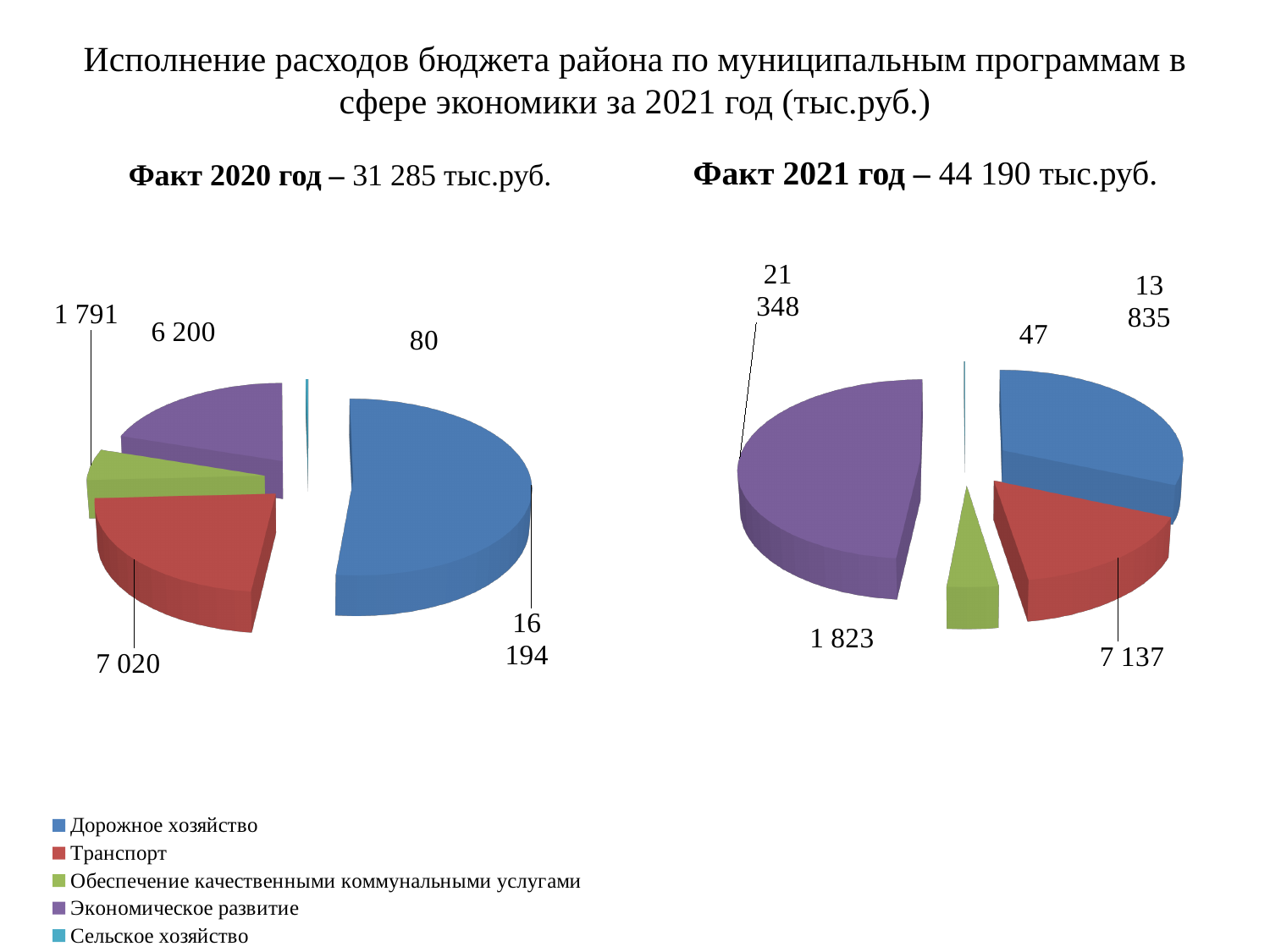
In the 2020 pie chart (Факт 2020 год), which category has the largest value? Дорожное хозяйство In the 2020 pie chart (Факт 2020 год), what is the value for Сельское хозяйство? 80 How many categories does the legend list for the pie charts? 5 In the 2021 pie chart (Факт 2021 год), what is the value for Транспорт? 7 137 What type of chart is used on this slide? Pie chart In the 2020 pie chart (Факт 2020 год), what is the value for Дорожное хозяйство? 16 194 In the 2021 pie chart (Факт 2021 год), which is larger: Дорожное хозяйство or Транспорт? Дорожное хозяйство In the 2021 pie chart (Факт 2021 год), which category has the largest value? Экономическое развитие In the 2020 pie chart (Факт 2020 год), what is the difference between Дорожное хозяйство and Транспорт? 9 174 In the 2021 pie chart (Факт 2021 год), which category has the smallest value? Сельское хозяйство By how much did the value for Экономическое развитие in the 2021 pie chart exceed its value in the 2020 pie chart? 15 148 In the 2021 pie chart (Факт 2021 год), what is the value for Экономическое развитие? 21 348